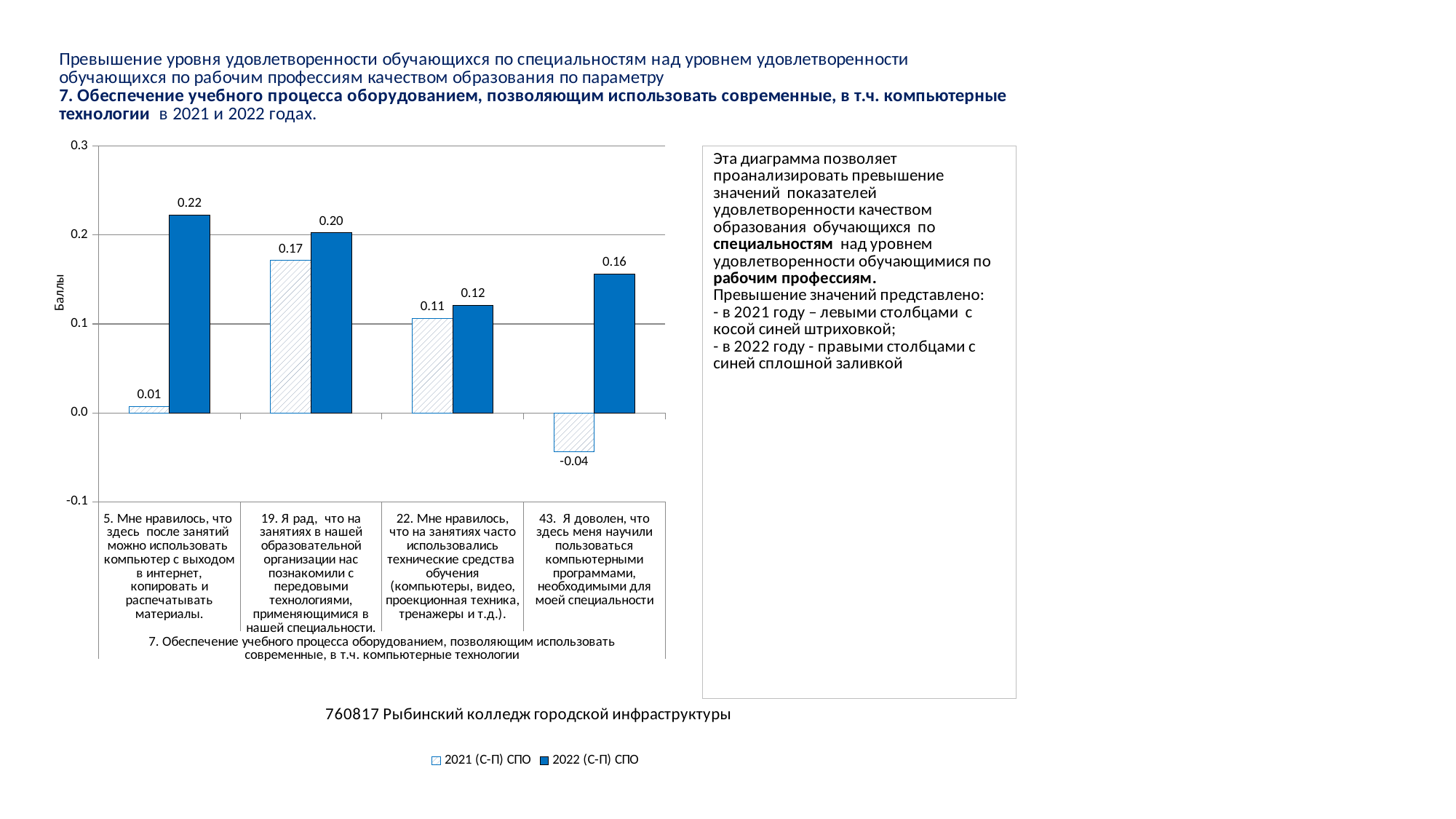
What is the label of the vertical axis? Баллы How many categories (statements) are shown on the x axis? 4 What is the value of the 2022 (С-П) СПО series for statement 5 ("Мне нравилось, что здесь после занятий можно использовать компьютер...")? 0.22 How many series does the legend list? 2 What type of chart is shown on the slide? bar chart What is the difference between the 2022 and 2021 values for statement 22 ("Мне нравилось, что на занятиях часто использовались технические средства обучения...")? 0.01 What is the value of the 2021 (С-П) СПО series for statement 43 ("Я доволен, что здесь меня научили пользоваться компьютерными программами...")? -0.04 For statement 19, which series has the larger value: 2021 (С-П) СПО or 2022 (С-П) СПО? 2022 (С-П) СПО What is the value of the 2021 (С-П) СПО series for statement 19 ("Я рад, что на занятиях в нашей образовательной организации нас познакомили с передовыми технологиями...")? 0.17 What is the difference between the 2022 and 2021 values for statement 5? 0.21 Which statement has the lowest value in the 2021 (С-П) СПО series? 43. Я доволен, что здесь меня научили пользоваться компьютерными программами, необходимыми для моей специальности Which statement has the highest value in the 2022 (С-П) СПО series? 5. Мне нравилось, что здесь после занятий можно использовать компьютер с выходом в интернет, копировать и распечатывать материалы.